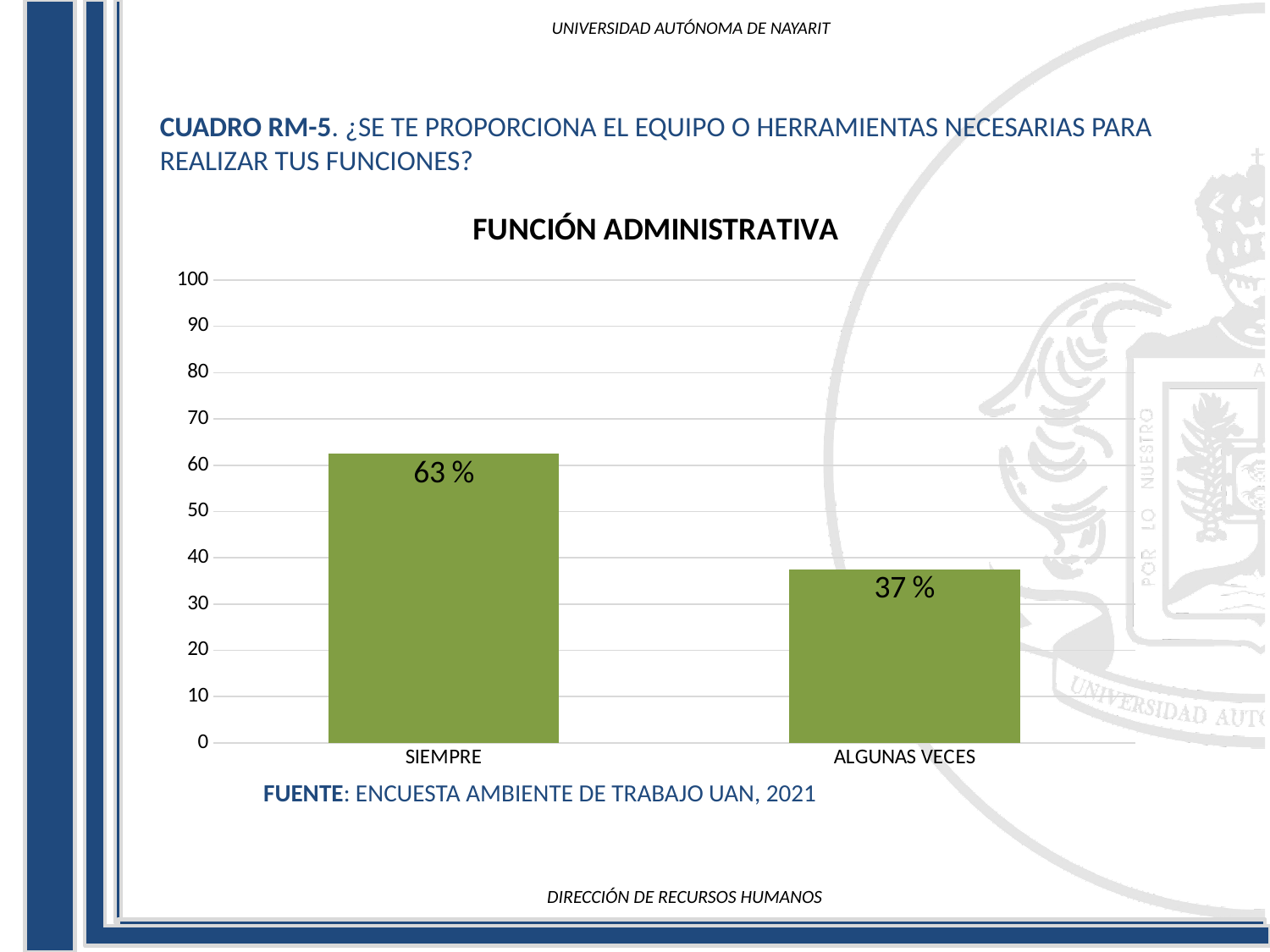
How many categories are shown on the x axis? 2 What is the maximum value shown on the y axis? 100 What is the value for SIEMPRE? 63 % Which is larger, the value for SIEMPRE or the value for ALGUNAS VECES? SIEMPRE What is the title of the chart? FUNCIÓN ADMINISTRATIVA What is the value for ALGUNAS VECES? 37 % Is the value for ALGUNAS VECES greater or less than 40? less Which category has the lowest value? ALGUNAS VECES Which category has the highest value? SIEMPRE What kind of chart is shown on the slide? bar chart Is the value for SIEMPRE greater or less than 60? greater What is the difference between the values for SIEMPRE and ALGUNAS VECES? 26 %